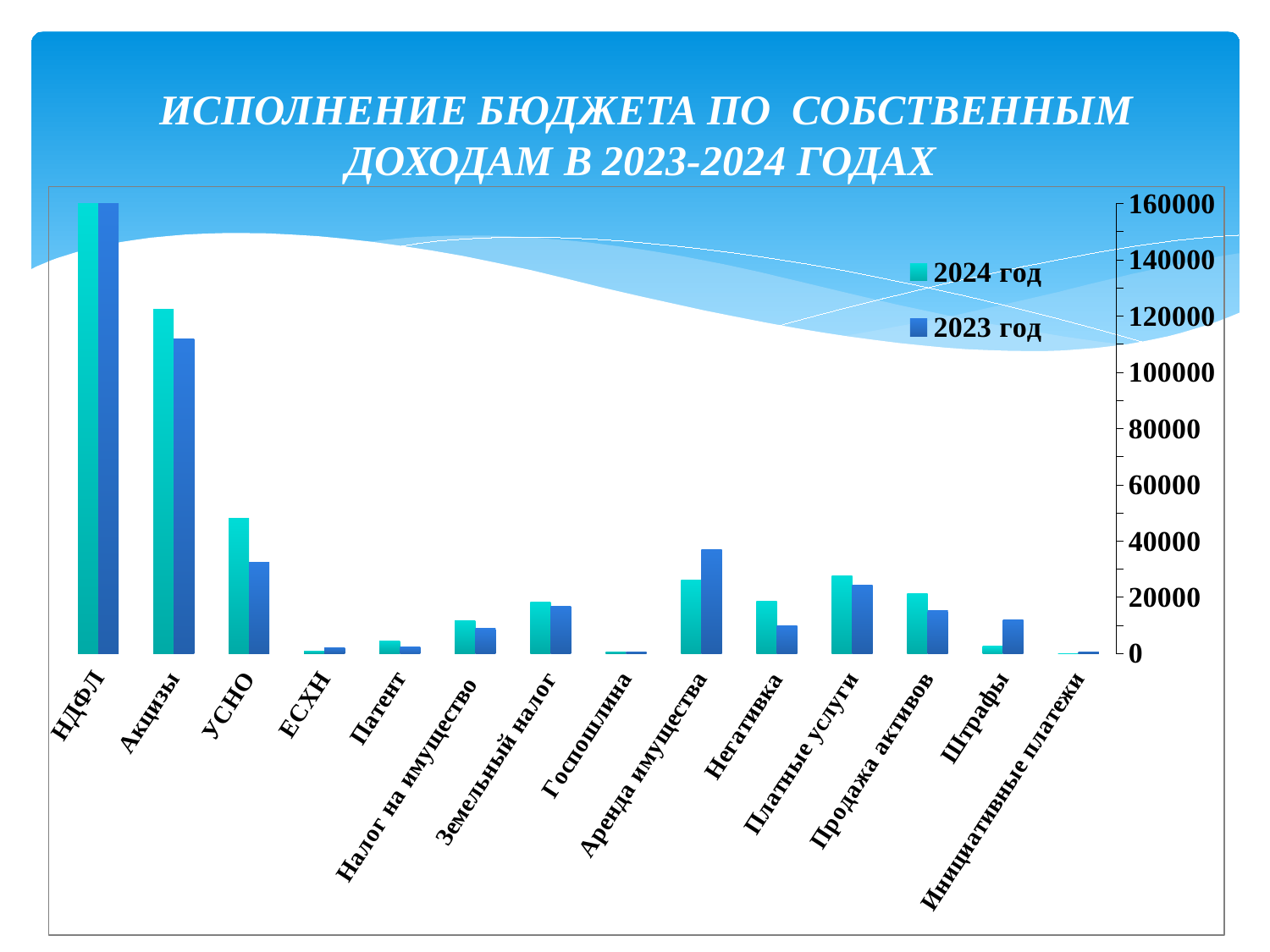
For Аренда имущества, which series has the larger value, 2024 год or 2023 год? 2023 год What kind of chart is shown on the slide? bar chart Which category has the highest value for 2023 год? НДФЛ Is the value for Акцизы in 2024 год greater or less than 100000? greater Which category has the highest value for 2024 год? НДФЛ How many series does the legend list? 2 How many categories are shown along the x axis? 14 Is the value for Налог на имущество in 2024 год greater or less than 20000? less For Штрафы, which series has the larger value, 2024 год or 2023 год? 2023 год For УСНО, which series has the larger value, 2024 год or 2023 год? 2024 год Is the value for УСНО in 2023 год greater or less than 40000? less Which colour represents the 2024 год series in the legend? teal (turquoise)